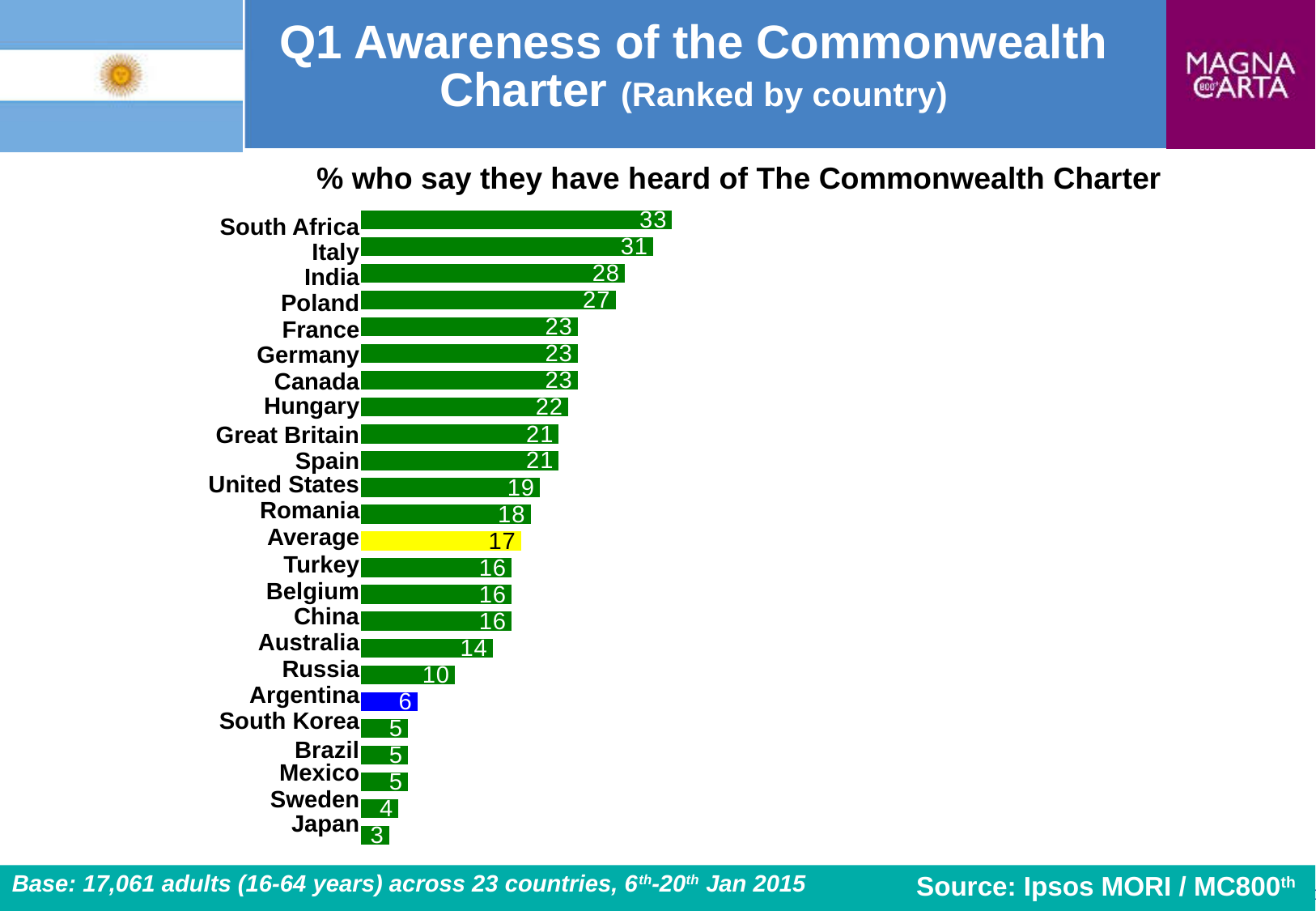
Which country has the lowest percentage who say they have heard of The Commonwealth Charter? Japan How many bars are shown on the chart, including the Average bar? 24 What is the difference between the values for Italy and Russia? 21 Which has a higher value, Australia or Argentina? Australia What is the Average value shown on the chart? 17 What kind of chart is shown on the slide? Bar chart Which has a higher value, India or Poland? India What is the value shown for Great Britain? 21 What is the value shown for Argentina? 6 What percentage of people in South Africa say they have heard of The Commonwealth Charter? 33 Which bar on the chart is coloured blue? Argentina Which country has the highest percentage who say they have heard of The Commonwealth Charter? South Africa